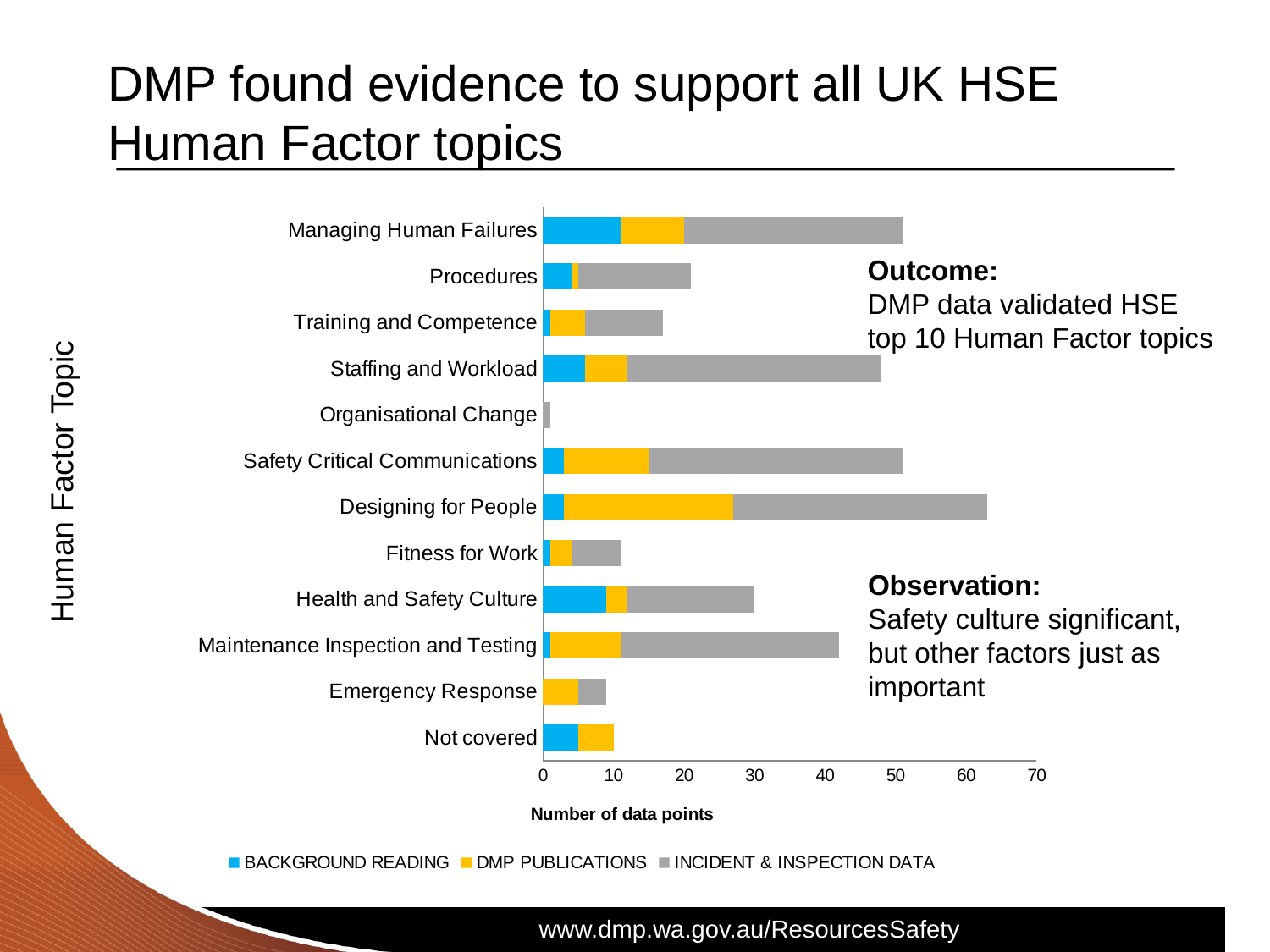
How many Human Factor Topic categories are plotted on the chart? 12 Which category has the shortest total bar? Organisational Change Which has the larger total bar, Designing for People or Managing Human Failures? Designing for People Which has the larger total bar, Health and Safety Culture or Procedures? Health and Safety Culture Is the total value for Training and Competence greater or less than 20? less Is the total value for Fitness for Work greater or less than 20? less Which series is shown in grey in the legend? INCIDENT & INSPECTION DATA How many series does the legend list? 3 What kind of chart is shown on the slide? Stacked bar chart What is the title of the horizontal axis? Number of data points Is the total value for Designing for People greater or less than 60? greater Which category has the longest total bar? Designing for People